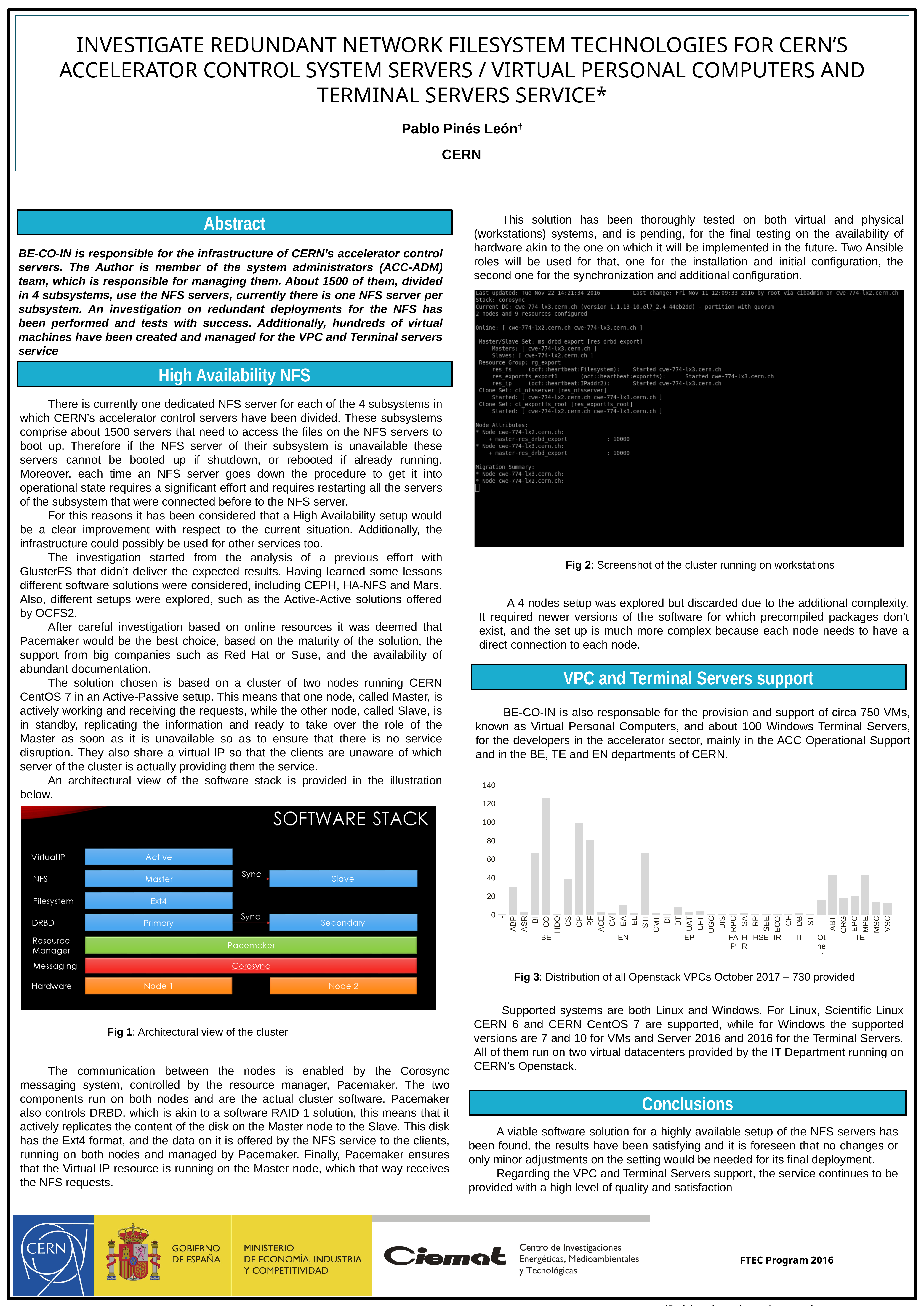
In Fig 3, is the value for OP greater or less than 80? greater In Fig 3, which category has the highest value? CO In Fig 3, is the value for ABP greater or less than 20? greater In Fig 3, is the value for MPE greater or less than 20? greater In Fig 3, which is larger, the value for CO or the value for OP? CO In Fig 3, which is larger, the value for BI or the value for ABP? BI What is the caption of the chart on the slide? Fig 3: Distribution of all Openstack VPCs October 2017 – 730 provided What kind of chart is Fig 3? bar chart